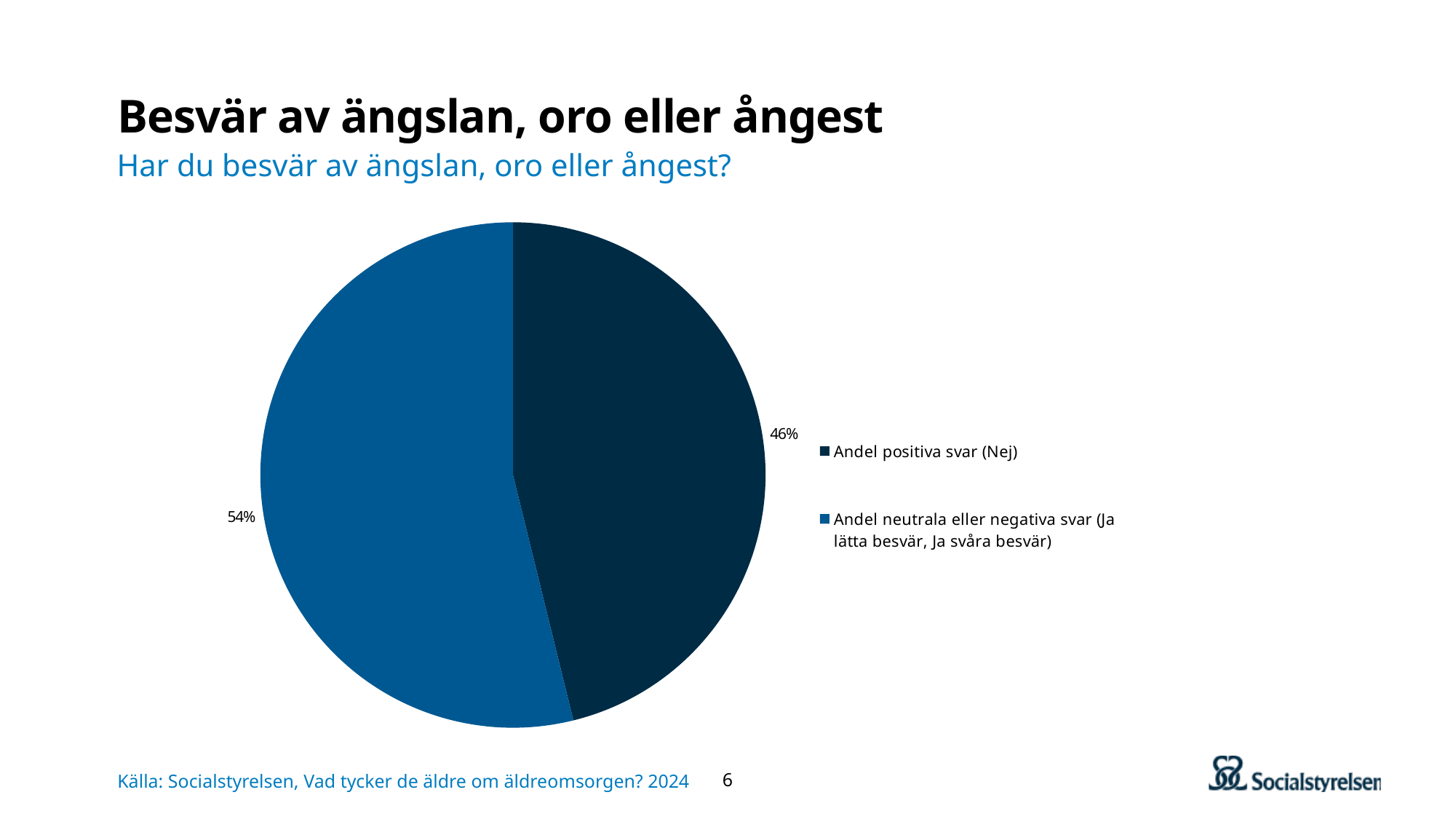
What kind of chart is shown on the slide? pie chart How many entries does the legend list? 2 Which slice of the pie is the largest? Andel neutrala eller negativa svar (Ja lätta besvär, Ja svåra besvär) Which is larger: the share for "Andel positiva svar (Nej)" or the share for "Andel neutrala eller negativa svar"? Andel neutrala eller negativa svar Is the share for "Andel positiva svar (Nej)" greater or less than 50%? less What share of the pie is labelled "Andel positiva svar (Nej)"? 46% Which slice of the pie is the smallest? Andel positiva svar (Nej) How many slices does the pie chart have? 2 What is the question shown as the subtitle above the chart? Har du besvär av ängslan, oro eller ångest? What share of the pie is labelled "Andel neutrala eller negativa svar (Ja lätta besvär, Ja svåra besvär)"? 54% What is the difference in percentage points between the two slices of the pie? 8 Which legend entry is shown in the darker blue colour? Andel positiva svar (Nej)